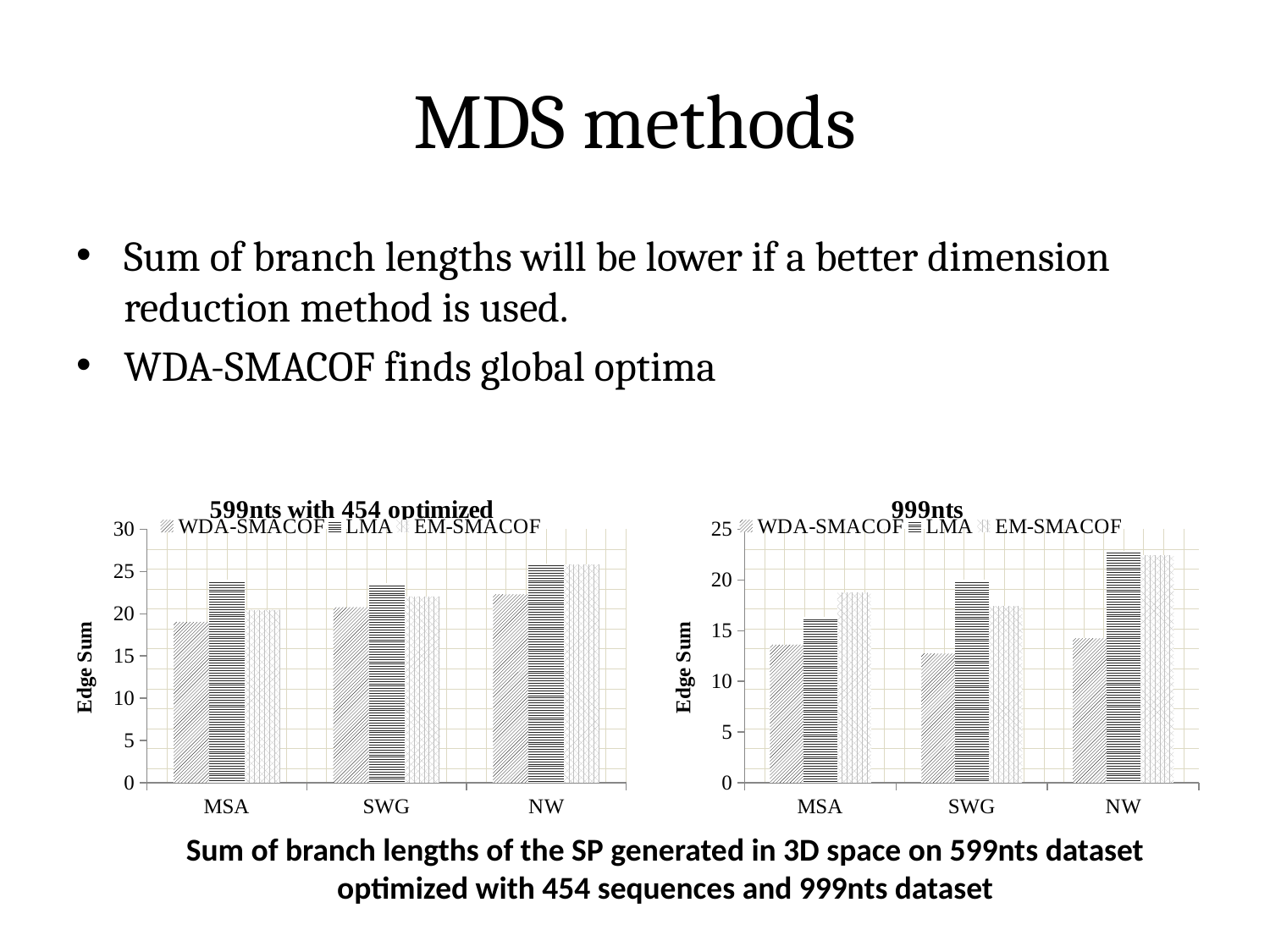
In the chart titled "999nts", which is larger at MSA: the value for LMA or the value for EM-SMACOF? EM-SMACOF In the chart titled "599nts with 454 optimized", is the value for WDA-SMACOF at MSA greater or less than 20? less In the chart titled "599nts with 454 optimized", what kind of chart is shown? bar chart In the chart titled "599nts with 454 optimized", is the value for LMA at NW greater or less than 25? greater In the chart titled "999nts", what is the label on the y axis? Edge Sum In the chart titled "599nts with 454 optimized", which is larger at SWG: the value for WDA-SMACOF or the value for LMA? LMA In the chart titled "599nts with 454 optimized", which series has the highest value at MSA? LMA In the chart titled "999nts", is the value for LMA at SWG greater or less than 15? greater In the chart titled "599nts with 454 optimized", how many categories are shown on the x axis? 3 In the chart titled "999nts", which series has the lowest value at NW? WDA-SMACOF In the chart titled "999nts", how many series does the legend list? 3